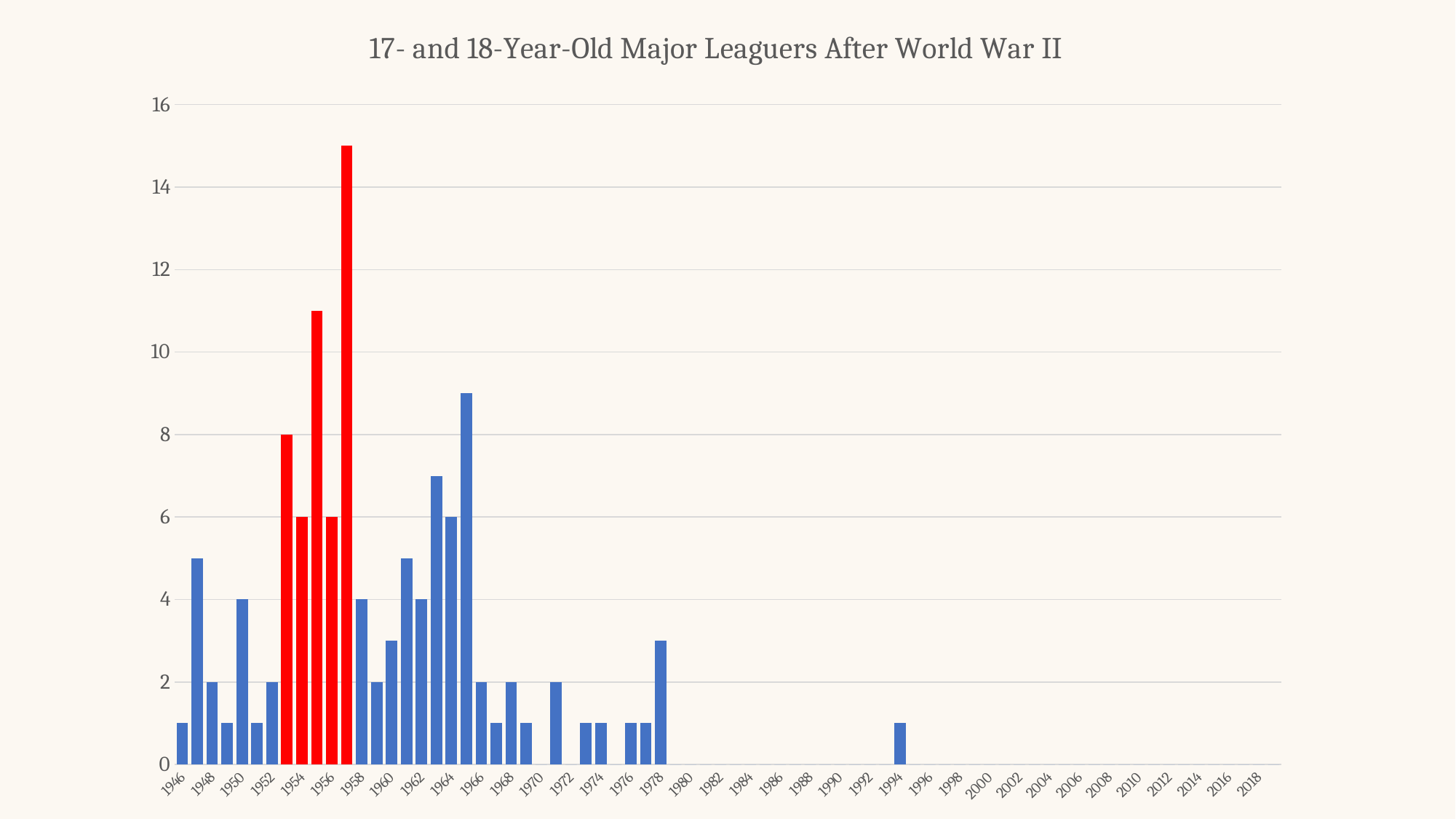
Is the value of the tallest bar greater or less than 14? greater What is the difference between the values for 1950 and 1948? 2 Do the values fall or rise from 1964 to 1968? fall What kind of chart is shown on the slide? bar chart What is the value for 1966? 2 What is the title of the chart? 17- and 18-Year-Old Major Leaguers After World War II What is the value for 1950? 4 What is the value for 1954? 6 Which year has the larger value, 1950 or 1952? 1950 What is the value for 1958? 4 Is the value for 1994 greater or less than 2? less What is the value for 1964? 6